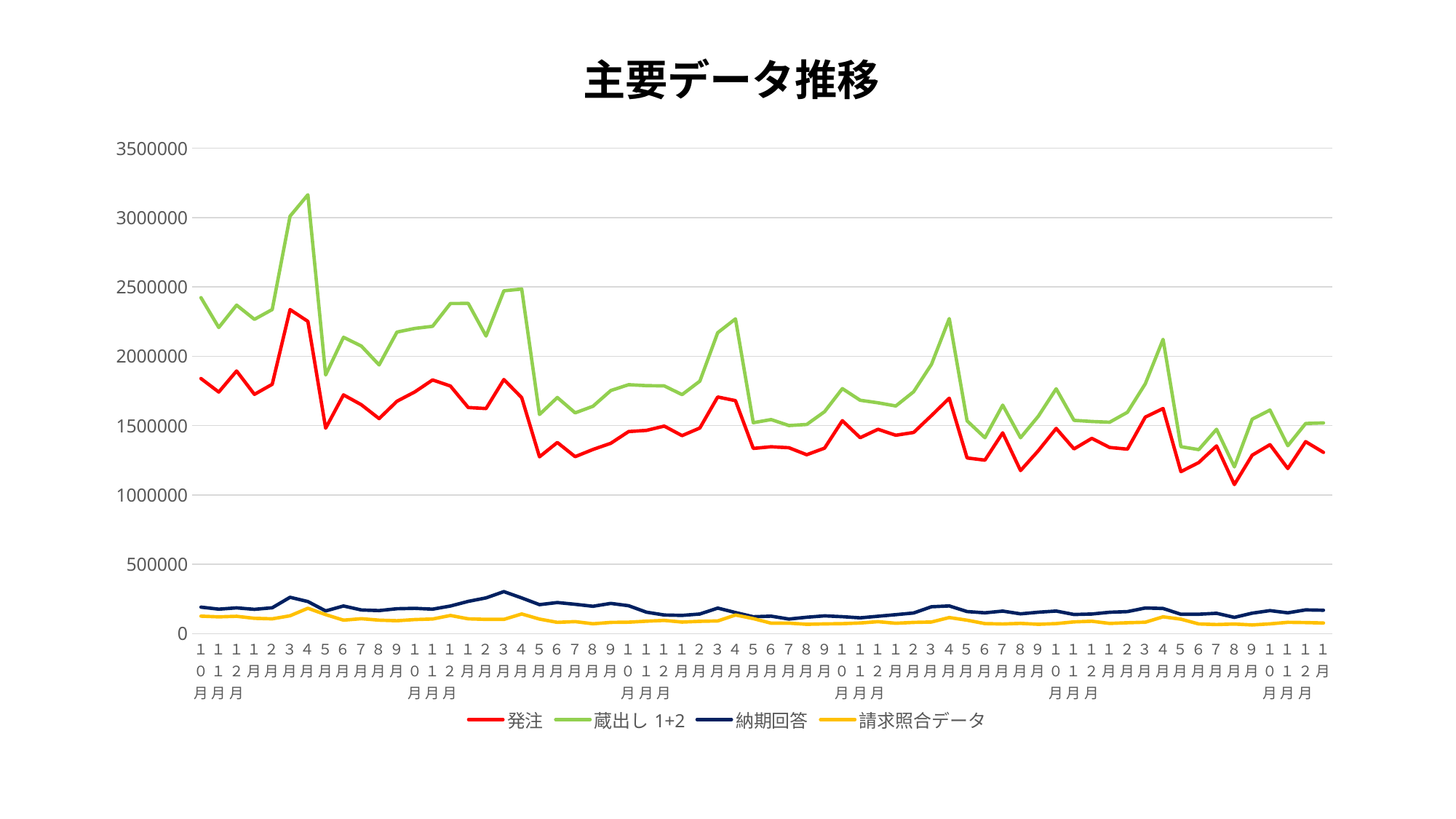
How many series does the legend list? 4 What is the title of the chart? 主要データ推移 Is the peak value of 蔵出し 1+2 greater or less than 3000000? greater Does the 発注 series rise or fall overall from the left to the right of the chart? fall Which series reaches the highest value on the chart? 蔵出し 1+2 Which series is higher, 納期回答 or 請求照合データ? 納期回答 Which series has the lowest values on the chart? 請求照合データ Is the first value of 発注 (at the leftmost 10月) greater or less than 1500000? greater What kind of chart is shown on the slide? line chart Which colour is used for the 発注 series? red Are the values of 納期回答 greater or less than 500000 throughout the chart? less Which series is higher throughout the chart, 蔵出し 1+2 or 発注? 蔵出し 1+2